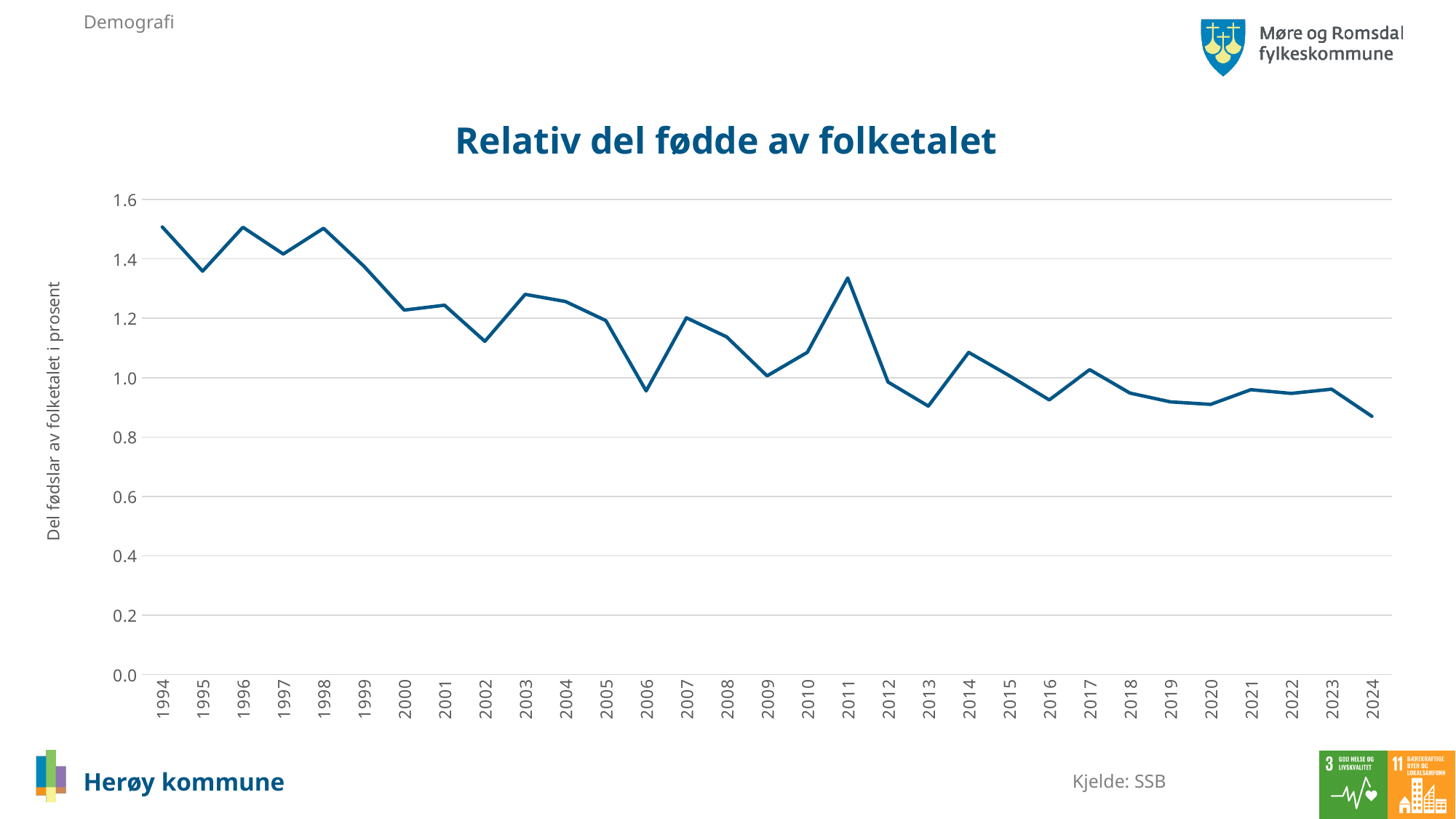
Is the value for 2024 greater or less than 1.0? less What kind of chart is shown on the slide? line chart What is the label on the vertical axis of the chart? Del fødslar av folketalet i prosent What is the title of the chart? Relativ del fødde av folketalet Is the value for 1994 greater or less than 1.4? greater Is the value for 2011 greater or less than 1.2? greater Which year has the larger value, 2011 or 2012? 2011 Which year has the larger value, 1994 or 2024? 1994 Overall, do the values rise or fall from 1994 to 2024? fall How many years are plotted along the x axis of the chart? 31